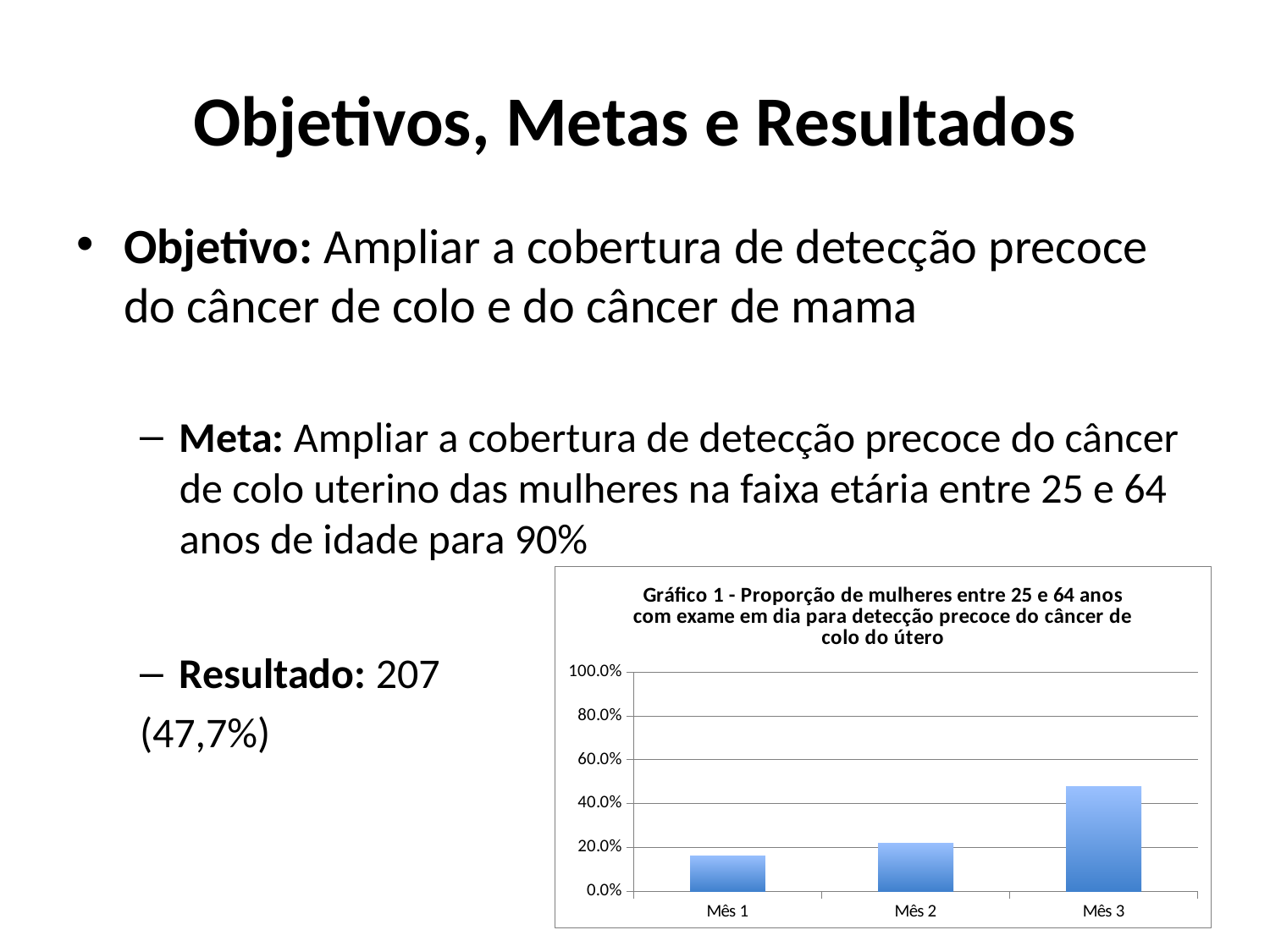
Which is larger, the value for Mês 2 or the value for Mês 3? Mês 3 Which month has the highest value in the chart? Mês 3 Which month has the lowest value in the chart? Mês 1 How many categories are plotted on the x axis of the chart? 3 Is the value for Mês 3 greater or less than 60.0%? less What is the highest value shown on the y axis of the chart? 100.0% Is the value for Mês 3 greater or less than 40.0%? greater What kind of chart is shown on the slide? bar chart Do the values rise or fall from Mês 1 to Mês 3? rise What is the title of the chart? Gráfico 1 - Proporção de mulheres entre 25 e 64 anos com exame em dia para detecção precoce do câncer de colo do útero Is the value for Mês 1 greater or less than 20.0%? less